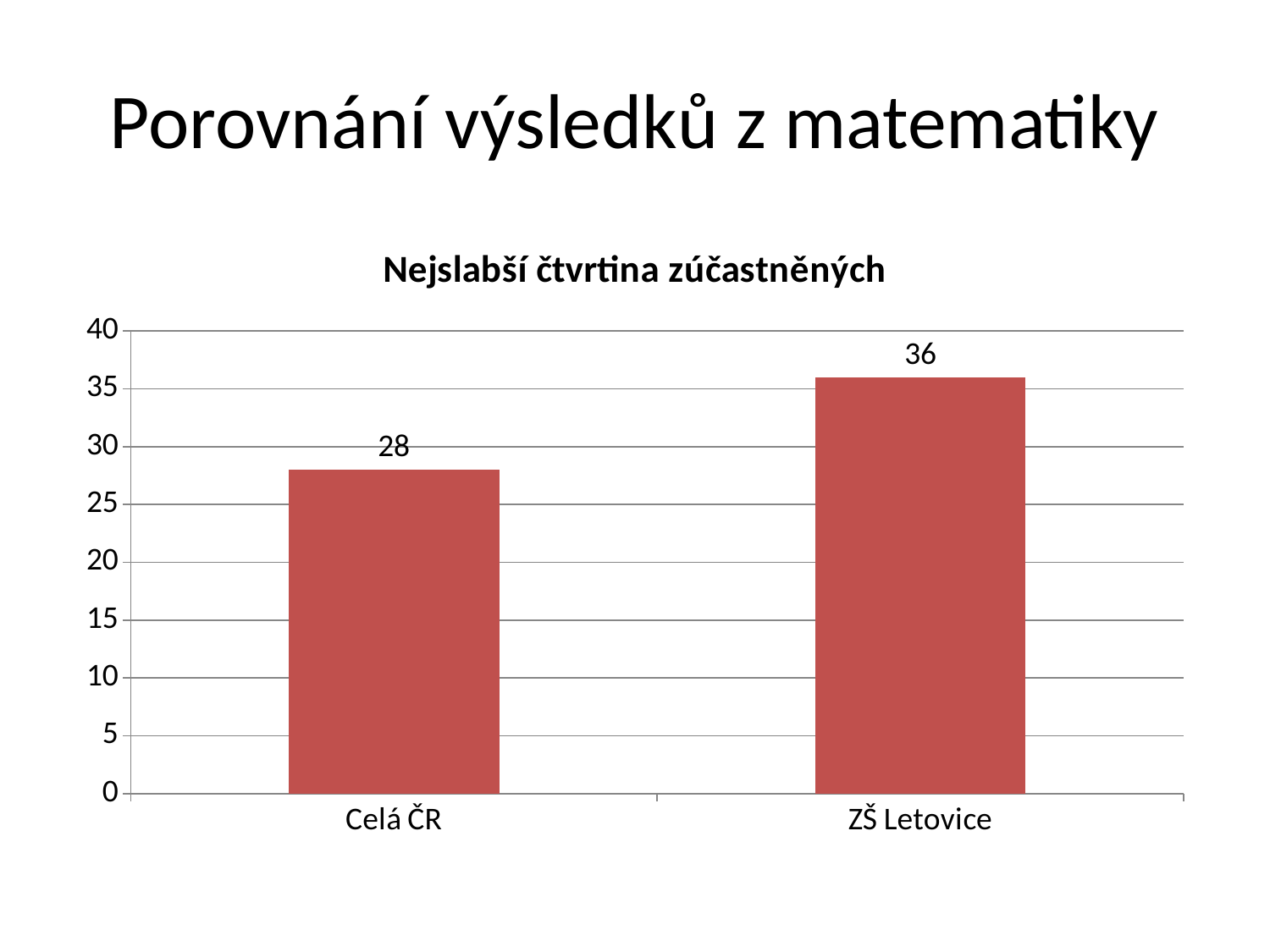
Is the value for Celá ČR greater or less than 30? less What is the value for ZŠ Letovice? 36 Is the value for ZŠ Letovice greater or less than 35? greater What is the value for Celá ČR? 28 Which is larger, the value for Celá ČR or the value for ZŠ Letovice? ZŠ Letovice What is the difference between the values for ZŠ Letovice and Celá ČR? 8 Which category has the lowest value? Celá ČR What is the title of the chart? Nejslabší čtvrtina zúčastněných What kind of chart is shown on the slide? bar chart How many categories are shown on the x axis? 2 Which category has the highest value? ZŠ Letovice What is the maximum value shown on the y axis? 40